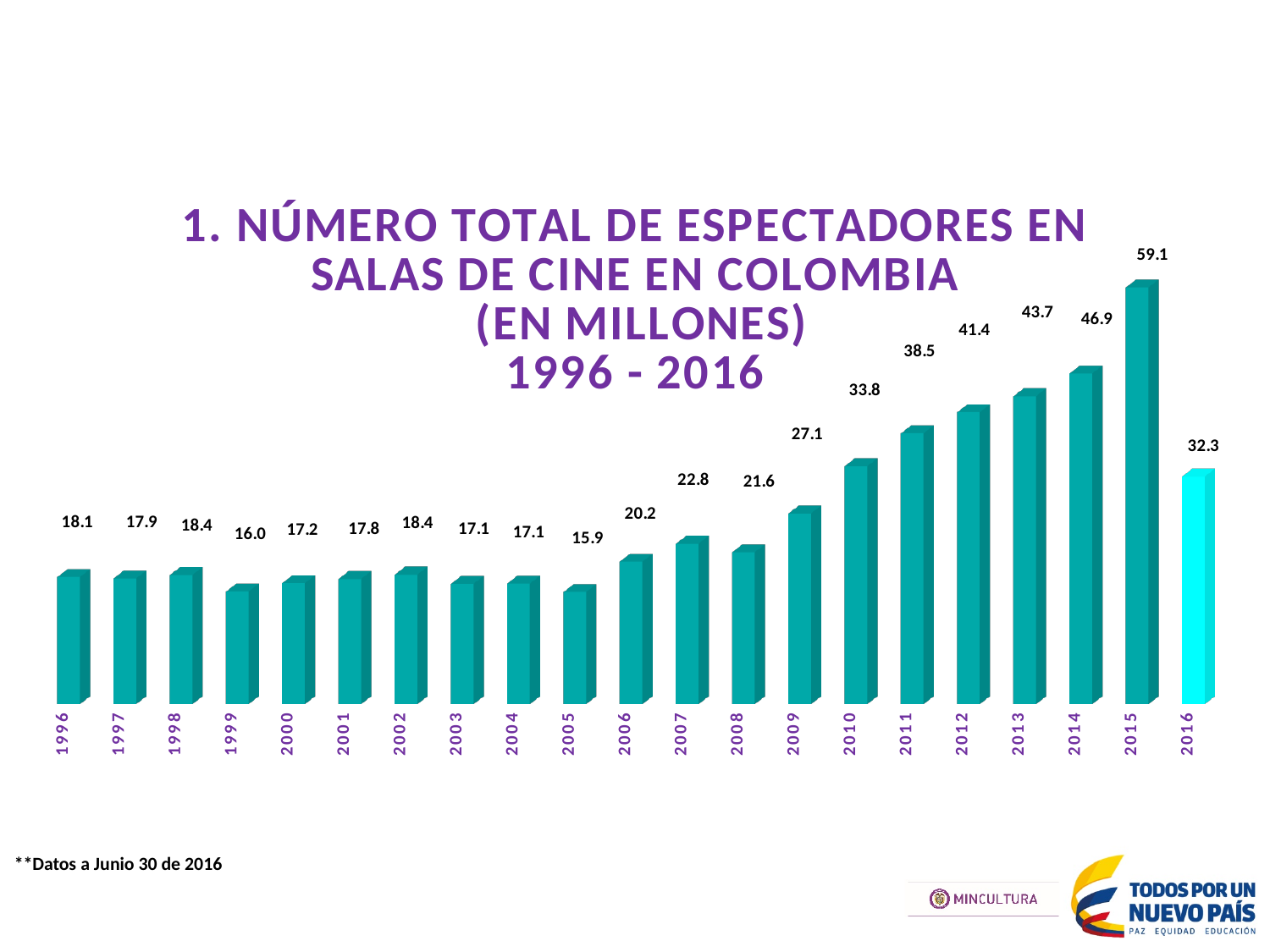
What kind of chart is shown? Bar chart How many years are shown on the x axis? 21 Which year has the highest value? 2015 What is the value for 2005? 15.9 Which is larger, the value for 2007 or the value for 2008? 2007 What is the value for 2016? 32.3 What is the value for 2015? 59.1 Do the values generally rise or fall from 2005 to 2015? Rise Which year has the lowest value? 2005 What is the difference between the values for 2010 and 2009? 6.7 Which bar is shown in a different, lighter colour than the others? 2016 What is the difference between the values for 2015 and 2014? 12.2